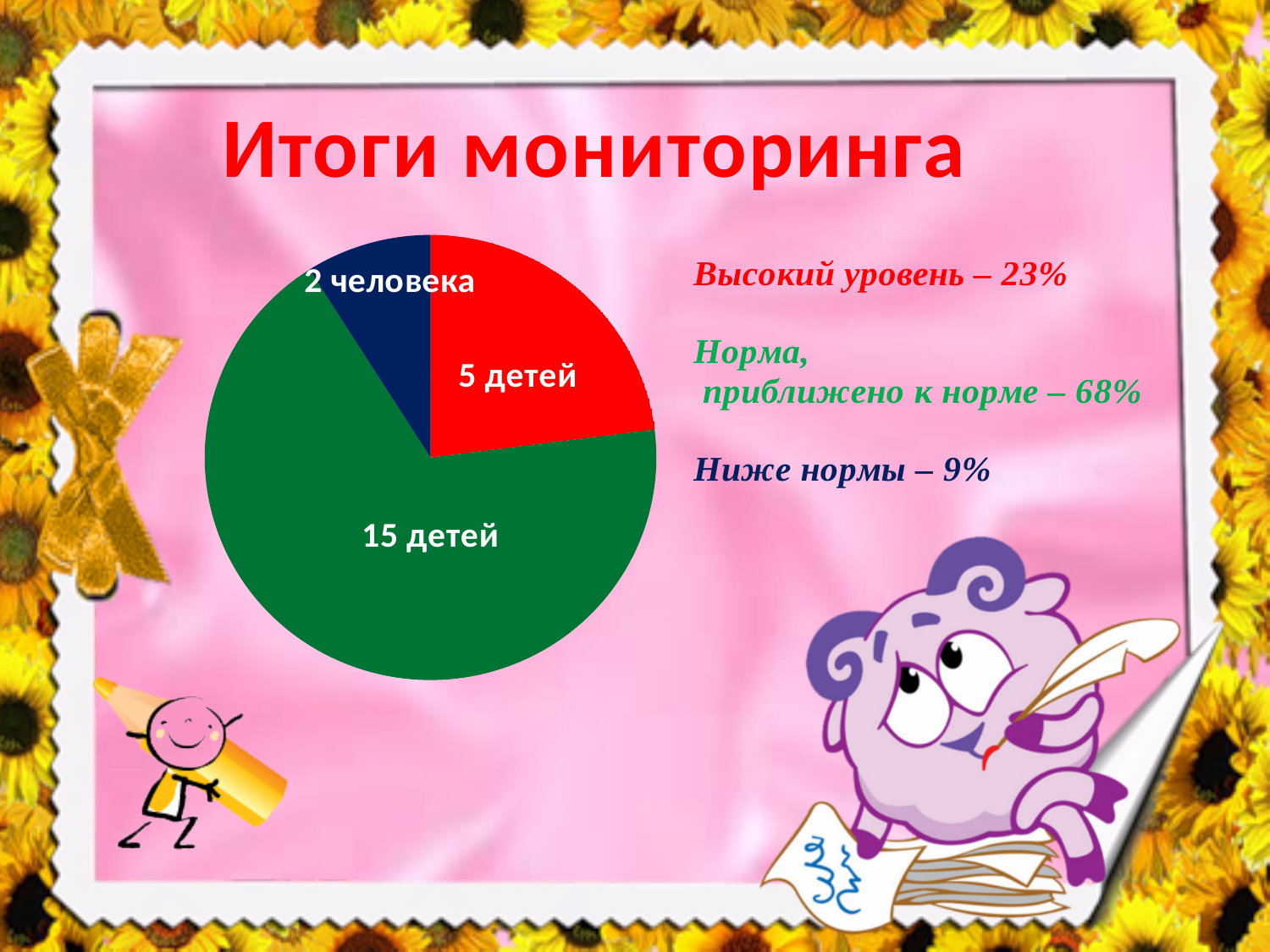
According to the slide, what share corresponds to 'Норма, приближено к норме'? 68% What is the value labelled on the red slice of the pie chart? 5 детей What is the title of the slide containing the pie chart? Итоги мониторинга What is the value labelled on the dark blue slice of the pie chart? 2 человека Which slice of the pie chart is the smallest? 2 человека (dark blue) What is the total number of children across all slices of the pie chart? 22 How many slices does the pie chart have? 3 What kind of chart is shown on the slide? pie chart How many more children are in the green slice than in the red slice? 10 Which slice of the pie chart is the largest? 15 детей (green) Which is larger, the red slice or the dark blue slice? the red slice What is the value labelled on the green slice of the pie chart? 15 детей